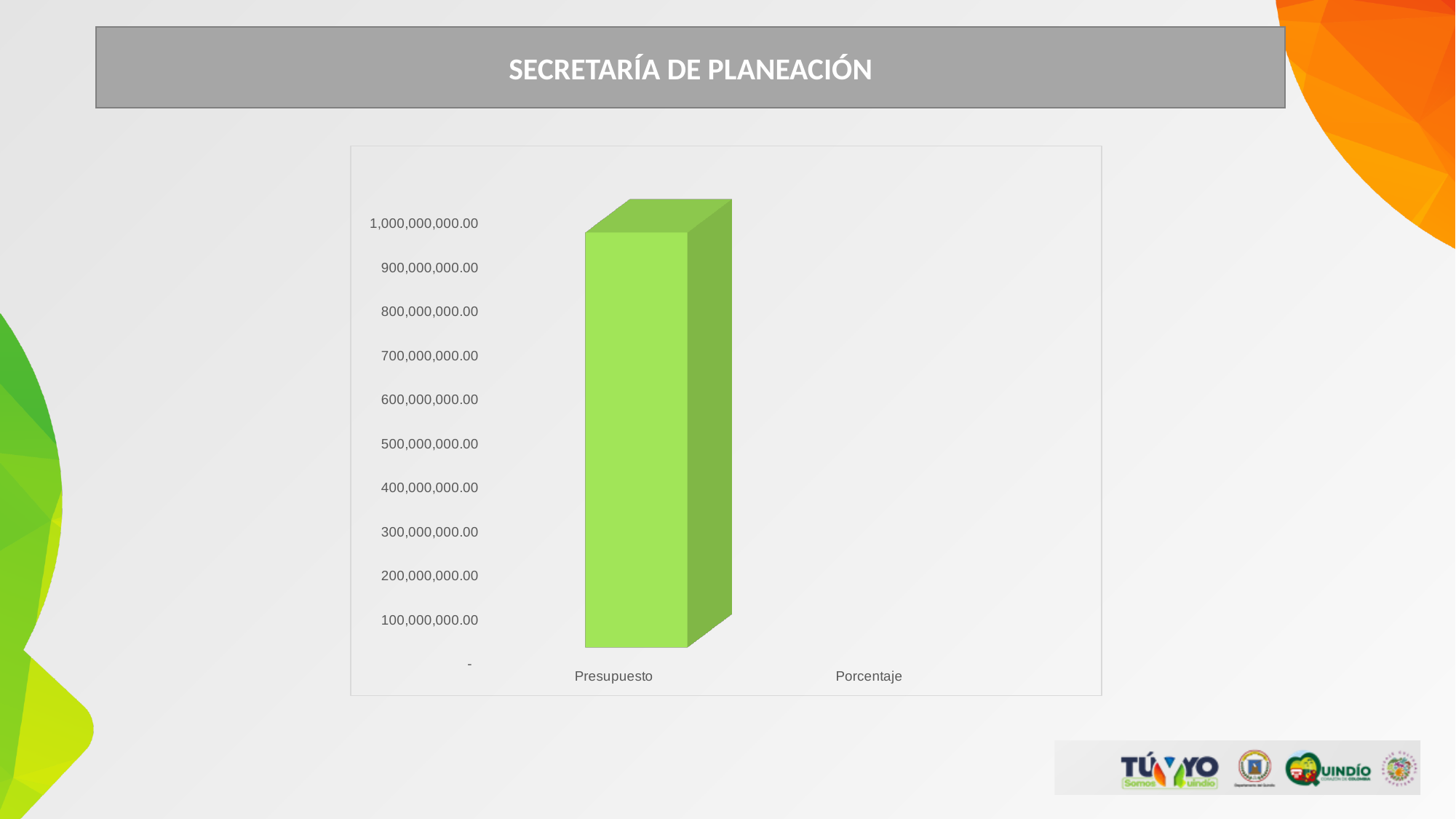
Is the value for Porcentaje greater or less than 100,000,000.00? less How many categories are shown on the x axis of the chart? 2 Which category has the lowest value in the chart? Porcentaje Is the value for Presupuesto greater or less than 800,000,000.00? greater Which is larger, the value for Presupuesto or the value for Porcentaje? Presupuesto Which category has the highest value in the chart? Presupuesto What kind of chart is shown on the slide? bar chart What colour is the bar for Presupuesto? green What is the highest tick value shown on the vertical axis of the chart? 1,000,000,000.00 Is the value for Presupuesto greater or less than 500,000,000.00? greater